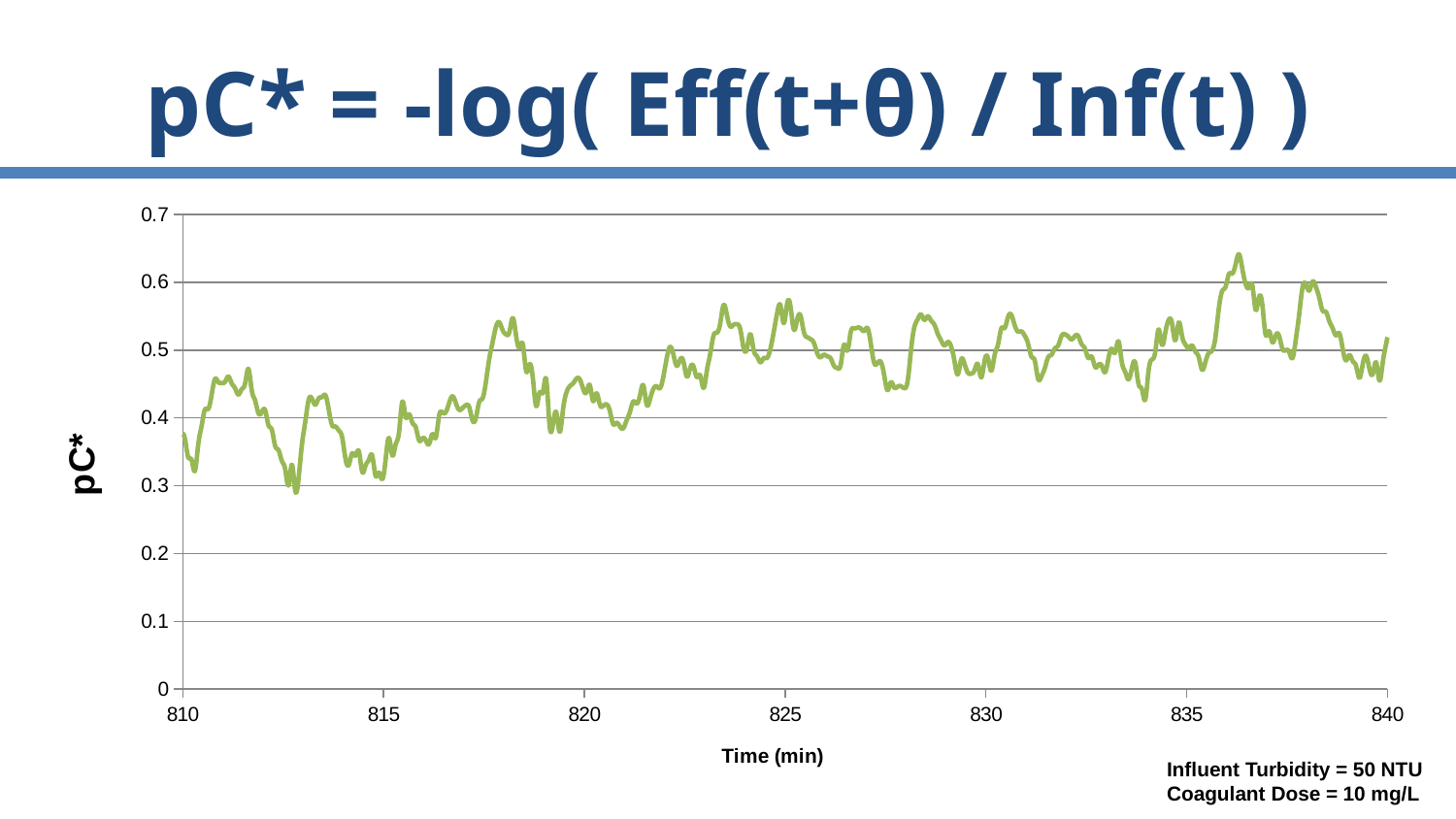
Is the pC* value at time 840 min greater or less than 0.4? greater Does the pC* line ever go above 0.7 on the chart? No What is the label of the y axis? pC* Overall, does the pC* value rise or fall as time increases from 810 to 840 minutes? rise Is the pC* value at time 830 min greater or less than 0.4? greater What is the label of the x axis? Time (min) How many labelled tick marks are on the x axis of the chart? 7 What kind of chart is shown on the slide? line chart What influent turbidity is stated in the note below the chart? 50 NTU